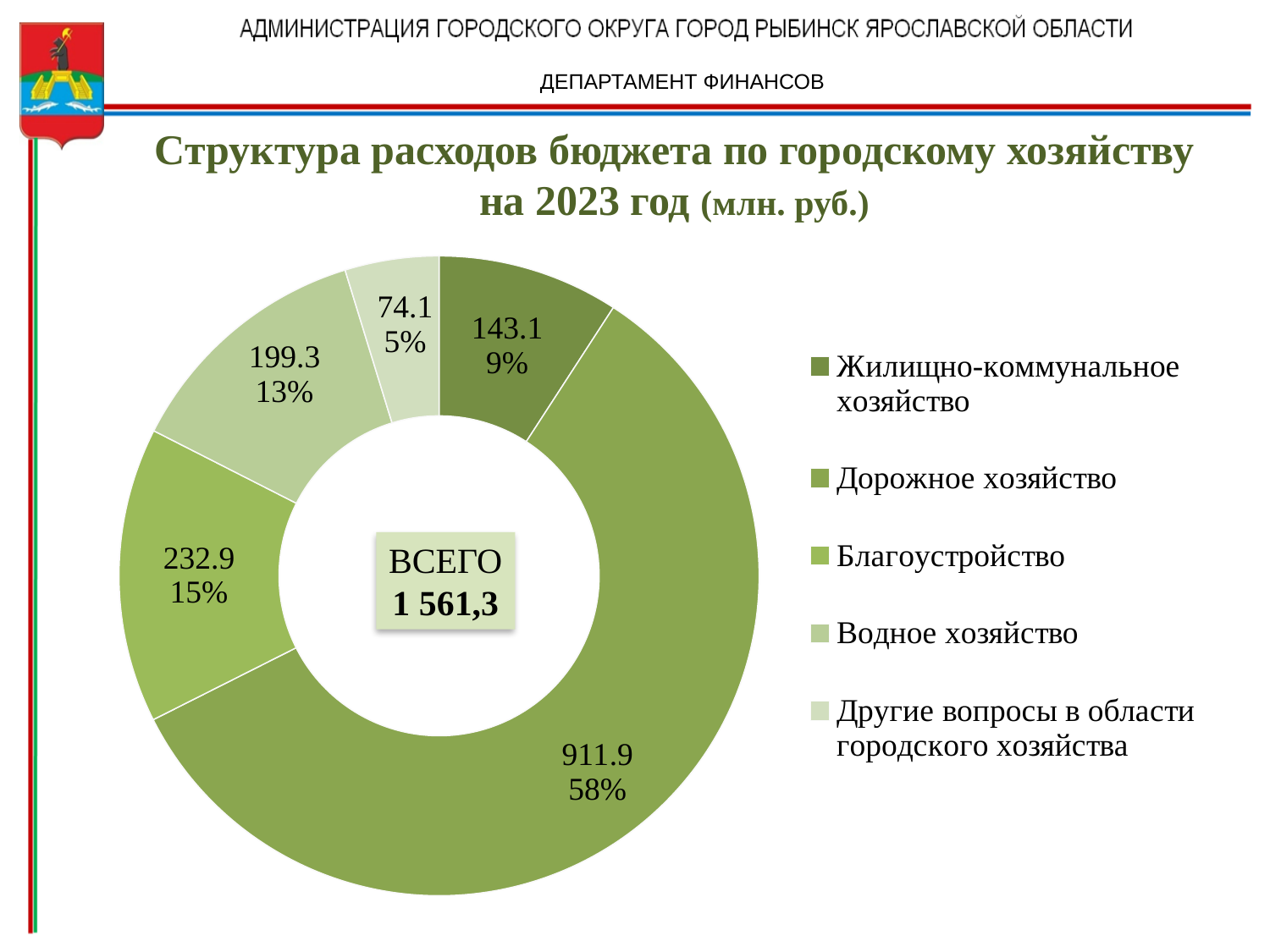
Which category has the largest value? Дорожное хозяйство What is the difference between the values for Благоустройство and Водное хозяйство? 33.6 What total (ВСЕГО) is shown in the centre of the chart? 1 561,3 What is the value for Жилищно-коммунальное хозяйство? 143.1 What share of the chart does Другие вопросы в области городского хозяйства represent? 5% What is the value for Дорожное хозяйство? 911.9 What is the value for Благоустройство? 232.9 What share of the chart does Водное хозяйство represent? 13% What type of chart is shown on the slide? Doughnut (pie) chart Which is larger, the value for Жилищно-коммунальное хозяйство or the value for Водное хозяйство? Водное хозяйство How many categories does the chart show? 5 Which category has the smallest value? Другие вопросы в области городского хозяйства